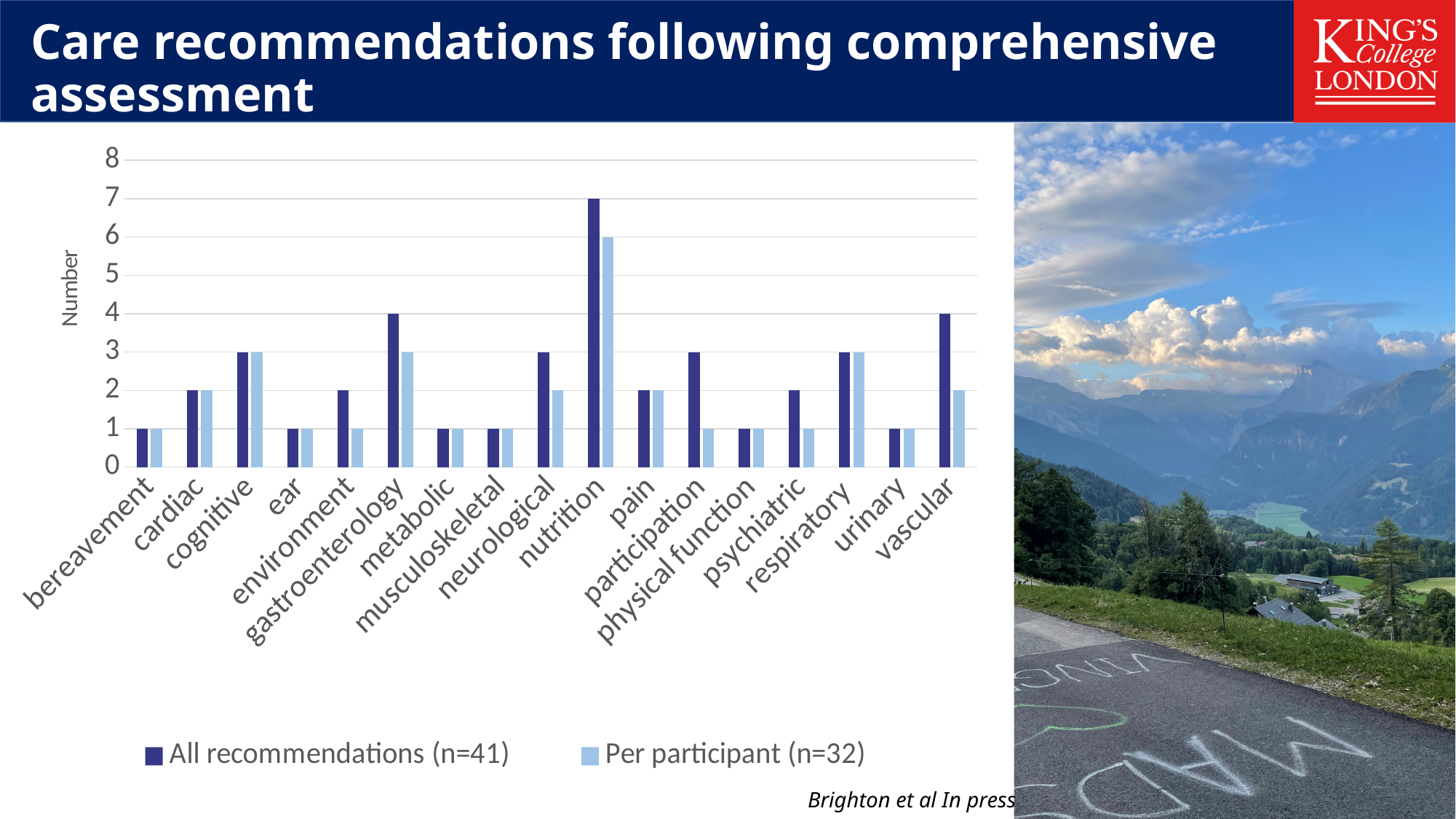
Which is larger for participation: the All recommendations (n=41) value or the Per participant (n=32) value? All recommendations (n=41) What is the difference between the All recommendations and Per participant values for vascular? 2 What is the value for respiratory in the Per participant (n=32) series? 3 What is the value for nutrition in the All recommendations (n=41) series? 7 Which category has the highest value in the All recommendations (n=41) series? nutrition How many series does the legend list? 2 Is the value for nutrition in the All recommendations (n=41) series greater or less than 5? greater What is the label of the y axis? Number What is the value for nutrition in the Per participant (n=32) series? 6 What is the value for gastroenterology in the All recommendations (n=41) series? 4 What kind of chart is shown on the slide? bar chart How many categories are shown on the x axis? 17